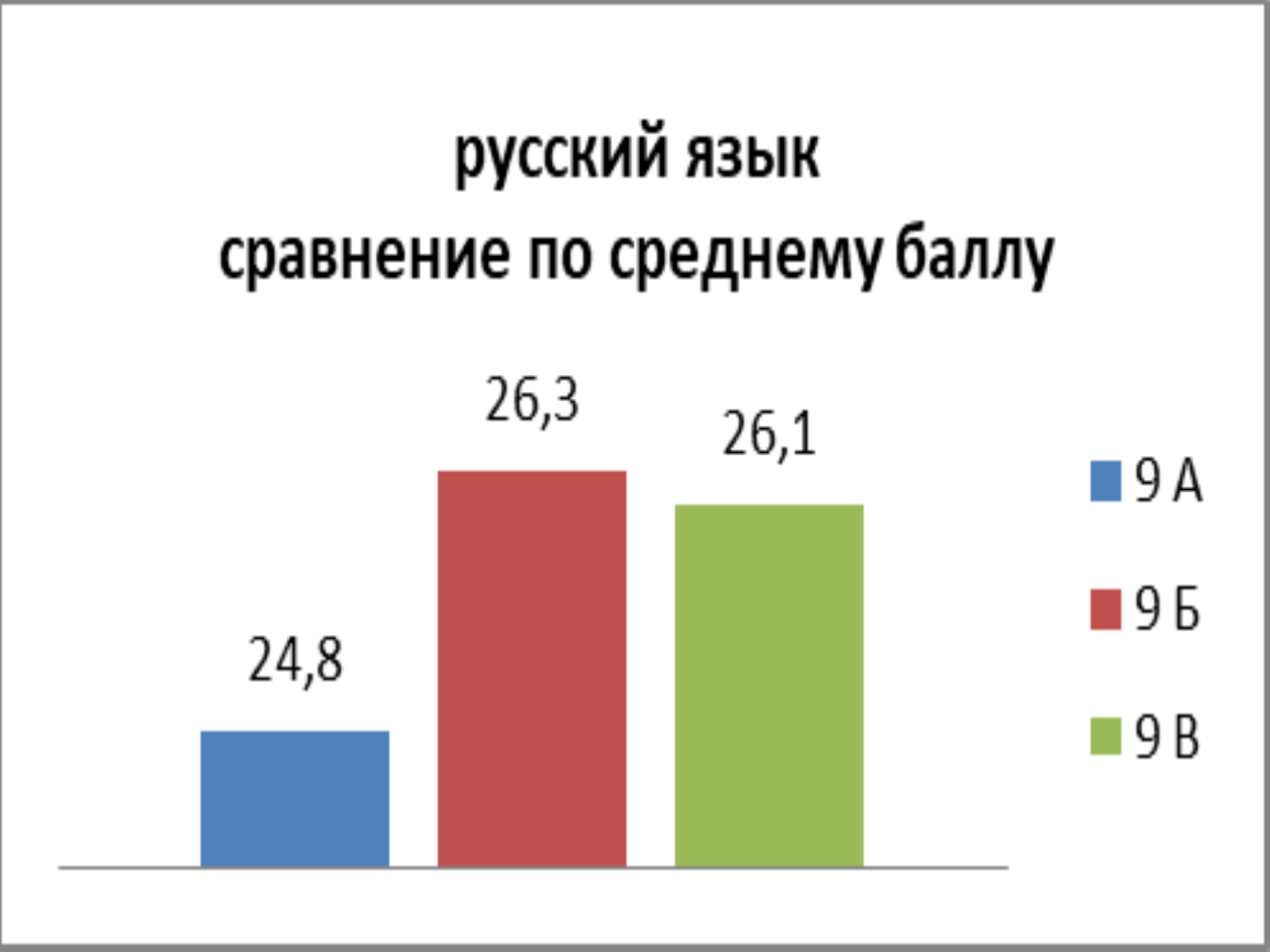
How many entries does the legend list? 3 What kind of chart is shown on the slide? bar chart What is the difference between the values for 9 Б and 9 В? 0,2 Which class has the lowest average score? 9 А Which class has the highest average score? 9 Б What is the value for 9 Б? 26,3 What is the value for 9 В? 26,1 What is the value for 9 А? 24,8 How many bars are shown in the chart? 3 Which is larger, the value for 9 А or the value for 9 В? 9 В What is the difference between the values for 9 Б and 9 А? 1,5 What colour is the bar for 9 Б? red